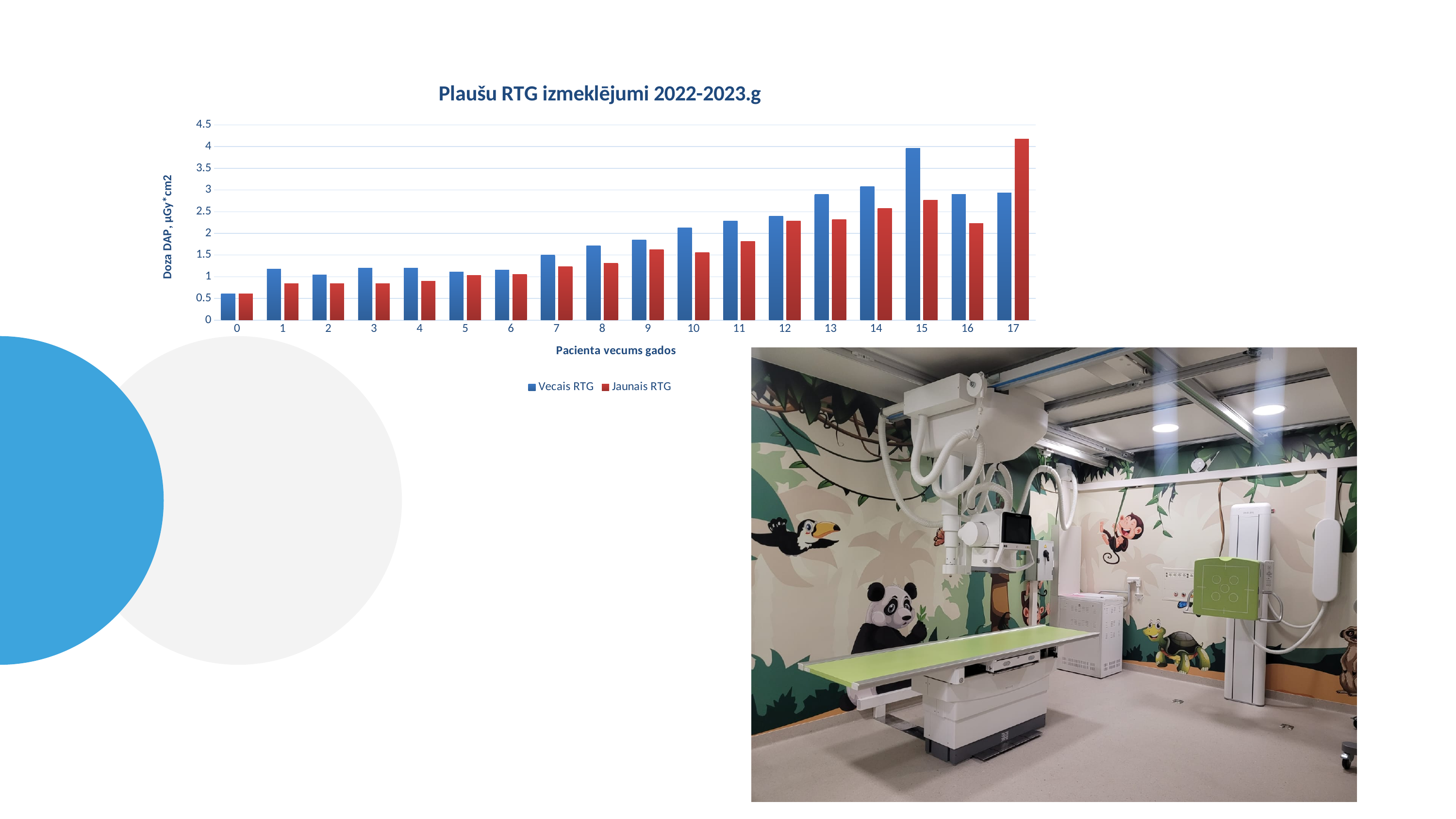
At age 15, which series has the larger value, Vecais RTG or Jaunais RTG? Vecais RTG At which patient age is the Vecais RTG value highest? 15 How many age categories are shown on the x axis? 18 Is the Jaunais RTG value at age 1 greater or less than 1? less At which patient age is the Vecais RTG value lowest? 0 At which patient age is the Jaunais RTG value highest? 17 What kind of chart is shown on the slide? bar chart Is the Vecais RTG value at age 15 greater or less than 3.5? greater What is the title of the chart? Plaušu RTG izmeklējumi 2022-2023.g At age 17, which series has the larger value, Vecais RTG or Jaunais RTG? Jaunais RTG Between ages 7 and 15, do the Vecais RTG values generally rise or fall? rise How many series does the legend list? 2